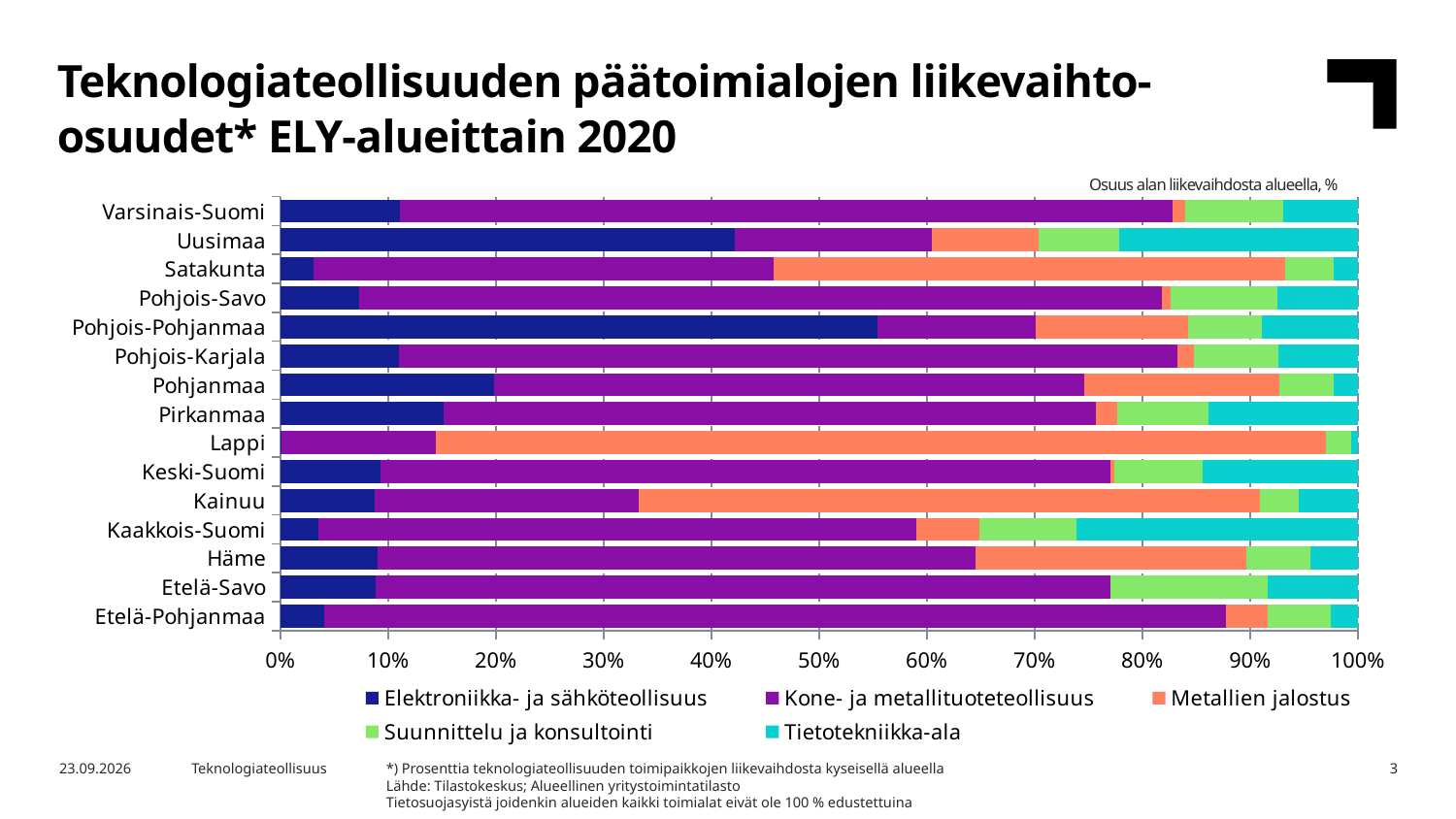
How many ELY regions are listed on the vertical axis of the chart? 15 Which has the larger Kone- ja metallituoteteollisuus share, Etelä-Pohjanmaa or Kainuu? Etelä-Pohjanmaa Is the Elektroniikka- ja sähköteollisuus share for Pohjois-Pohjanmaa greater or less than 50%? greater Which has the larger Elektroniikka- ja sähköteollisuus share, Uusimaa or Pohjois-Pohjanmaa? Pohjois-Pohjanmaa How many series does the chart legend list? 5 Which has the larger Tietotekniikka-ala share, Kaakkois-Suomi or Etelä-Pohjanmaa? Kaakkois-Suomi Which region has the largest Elektroniikka- ja sähköteollisuus share? Pohjois-Pohjanmaa Is the Elektroniikka- ja sähköteollisuus share for Uusimaa greater or less than 40%? greater Which region has the largest Metallien jalostus share? Lappi What kind of chart is shown on the slide? Stacked bar chart Is the Elektroniikka- ja sähköteollisuus share for Satakunta greater or less than 10%? less What is the first series listed in the chart legend? Elektroniikka- ja sähköteollisuus